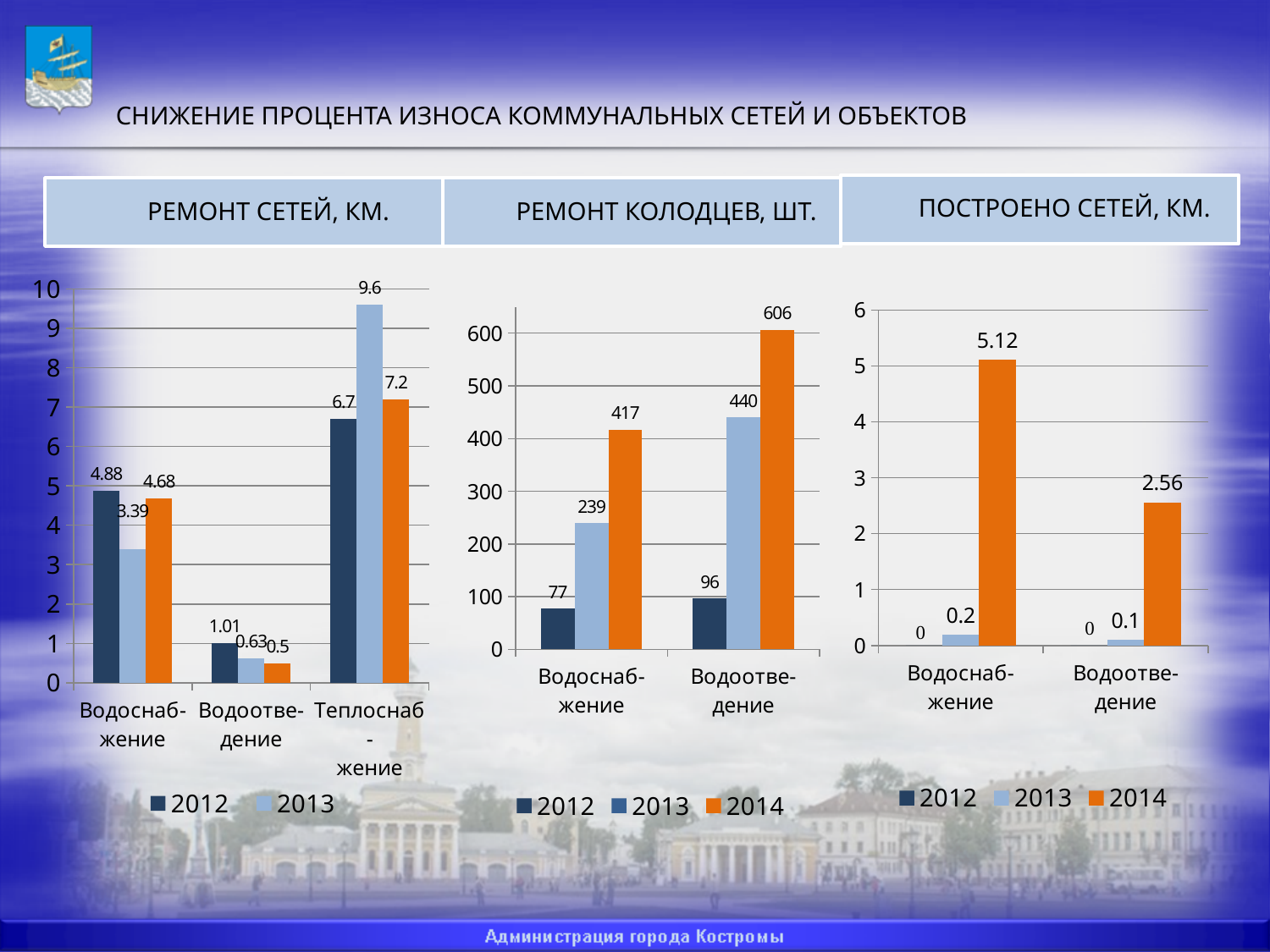
In the chart 'РЕМОНТ КОЛОДЦЕВ, ШТ.', which is larger: the 2012 value for Водоснабжение or the 2012 value for Водоотведение? Водоотведение In the chart 'РЕМОНТ КОЛОДЦЕВ, ШТ.', what is the value for Водоотведение in 2014? 606 What type of chart is 'ПОСТРОЕНО СЕТЕЙ, КМ.'? bar chart In the chart 'РЕМОНТ СЕТЕЙ, КМ.', what is the value for Водоотведение in 2012? 1.01 In the chart 'РЕМОНТ СЕТЕЙ, КМ.', what is the value for Теплоснабжение in 2013? 9.6 In the chart 'РЕМОНТ КОЛОДЦЕВ, ШТ.', do the values for Водоснабжение rise or fall from 2012 to 2014? rise In the chart 'РЕМОНТ СЕТЕЙ, КМ.', which category has the highest value in 2013? Теплоснабжение In the chart 'РЕМОНТ СЕТЕЙ, КМ.', how many categories are shown on the x axis? 3 In the chart 'ПОСТРОЕНО СЕТЕЙ, КМ.', what is the value for Водоснабжение in 2014? 5.12 In the chart 'РЕМОНТ КОЛОДЦЕВ, ШТ.', how many series does the legend list? 3 In the chart 'РЕМОНТ КОЛОДЦЕВ, ШТ.', what is the difference between the 2014 and 2013 values for Водоснабжение? 178 In the chart 'ПОСТРОЕНО СЕТЕЙ, КМ.', what is the difference between the 2014 values for Водоснабжение and Водоотведение? 2.56